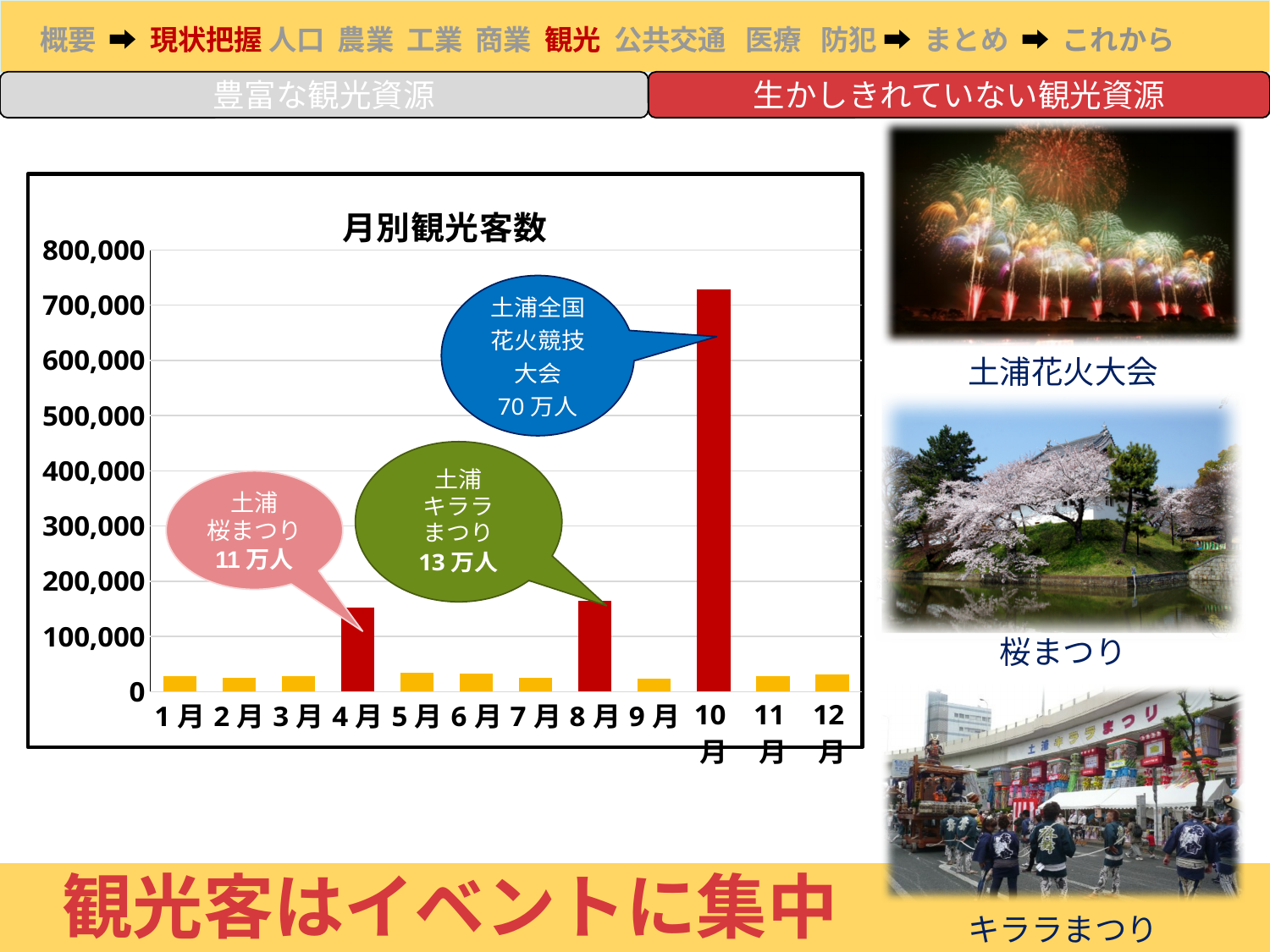
What is the title of the chart? 月別観光客数 According to the callout, how many people attend the 土浦全国花火競技大会 in 10月? 70万人 Which month has the highest number of visitors? 10月 Is the value for 10月 greater or less than 700,000? greater How many months (categories) are plotted on the x axis? 12 Is the value for 1月 greater or less than 100,000? less Is the value for 4月 greater or less than 200,000? less Which is larger, the value for 4月 or the value for 10月? 10月 Which months are drawn with red bars instead of yellow? 4月, 8月, 10月 Which is larger, the value for 8月 or the value for 9月? 8月 What kind of chart is shown on the slide? bar chart